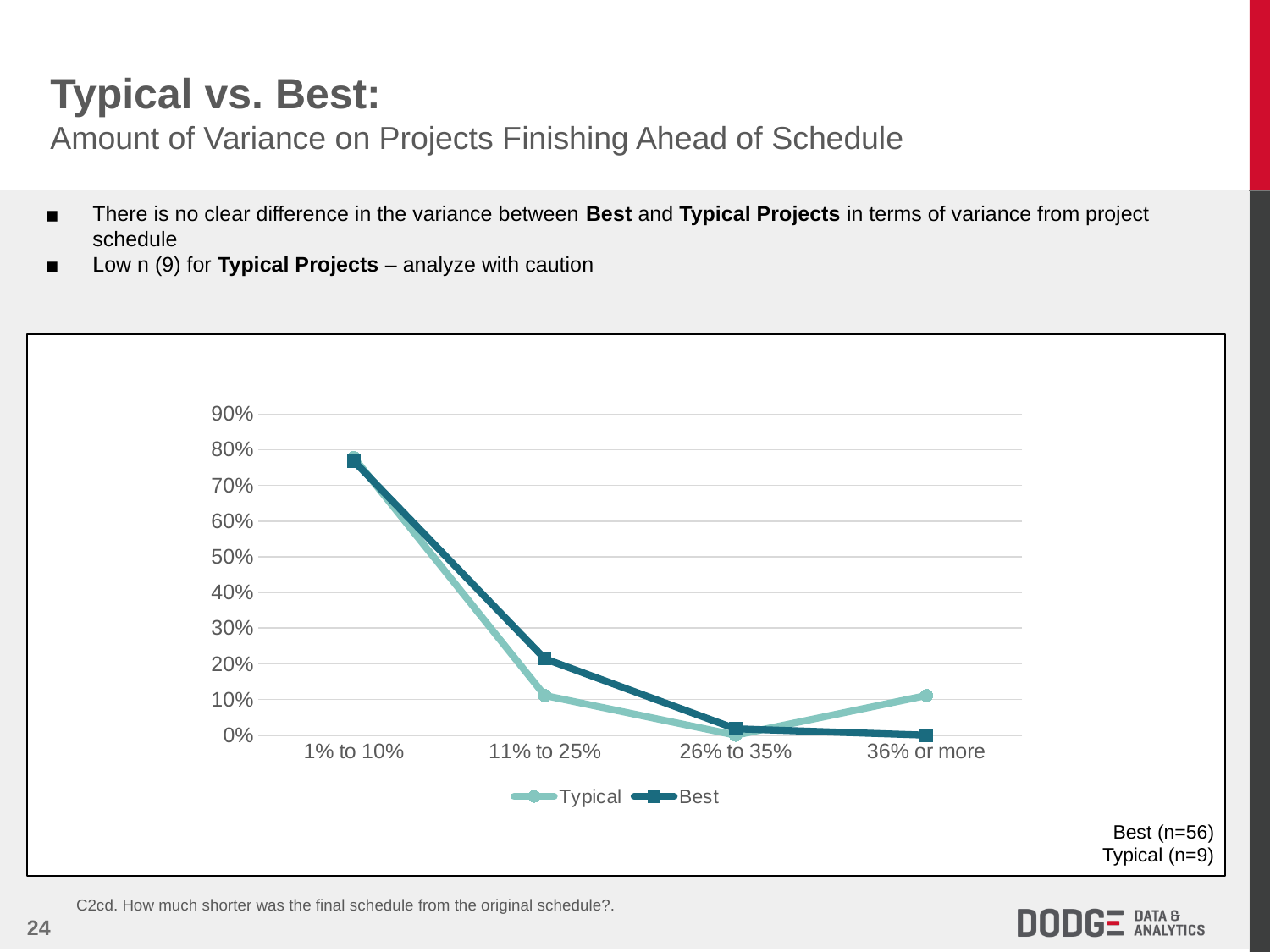
How many categories are shown on the x axis? 4 How many series does the legend list? 2 Is the value for Typical at 36% or more greater or less than 20%? less Is the value for Best at 11% to 25% greater or less than 30%? less Which category has the highest value for the Typical series? 1% to 10% At 36% or more, which series has the larger value, Typical or Best? Typical Which category has the lowest value for the Best series? 36% or more Does the Best series rise or fall from 1% to 10% to 36% or more? fall Is the value for Typical at 1% to 10% greater or less than 70%? greater At 11% to 25%, which series has the larger value, Typical or Best? Best Which category has the highest value for the Best series? 1% to 10% What kind of chart is shown on the slide? line chart